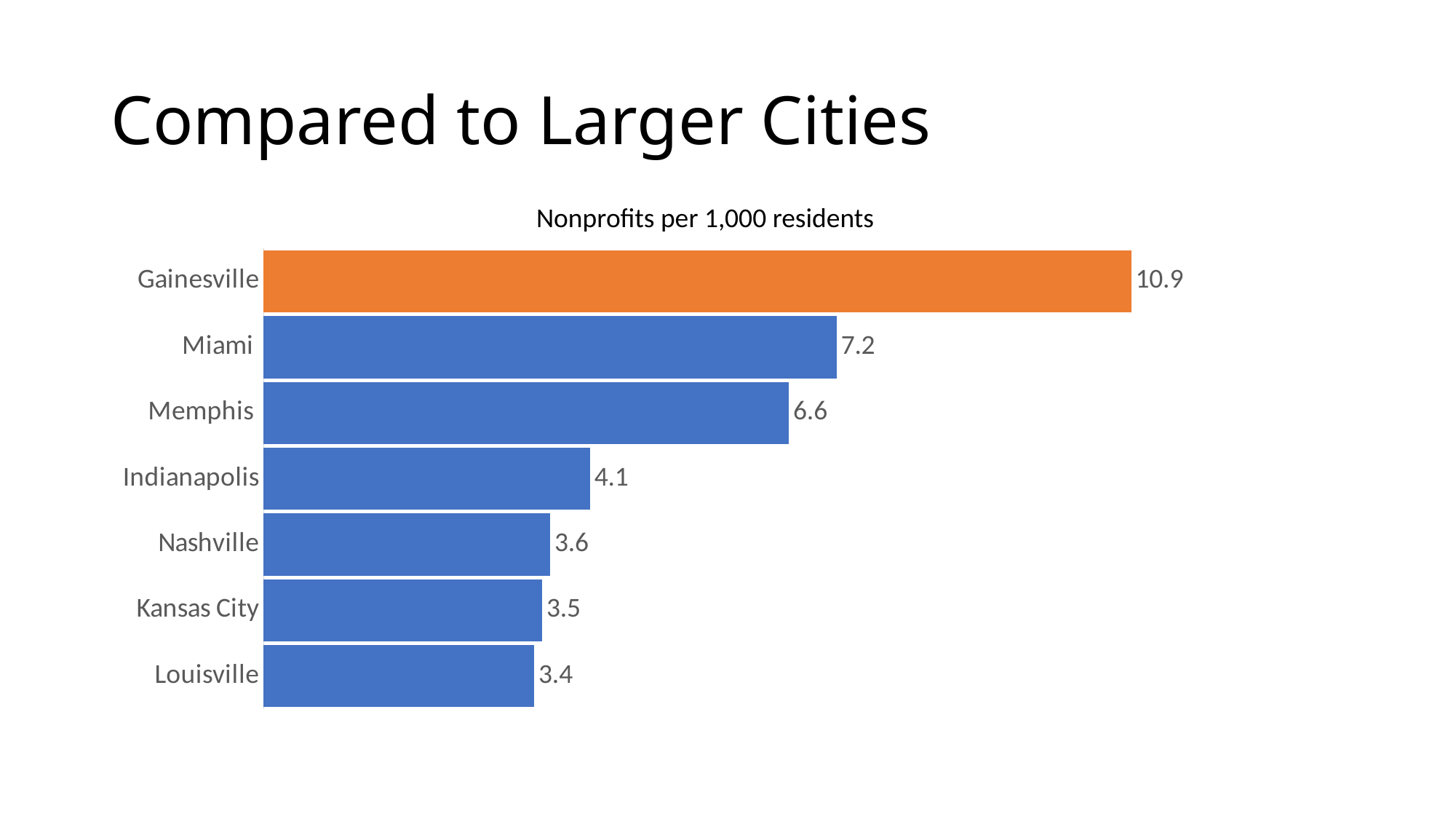
How many cities are shown in the chart? 7 What is the difference between the values for Gainesville and Miami? 3.7 What is the value for Memphis in the chart? 6.6 Which has a larger value, Miami or Memphis? Miami What is the value for Kansas City in the chart? 3.5 Which city's bar is coloured orange rather than blue? Gainesville What kind of chart is shown on the slide? Bar chart What is the value for Gainesville in the chart? 10.9 What is the title of the chart? Nonprofits per 1,000 residents Which city has the lowest number of nonprofits per 1,000 residents? Louisville Which city has the highest number of nonprofits per 1,000 residents? Gainesville What is the difference between the values for Indianapolis and Nashville? 0.5